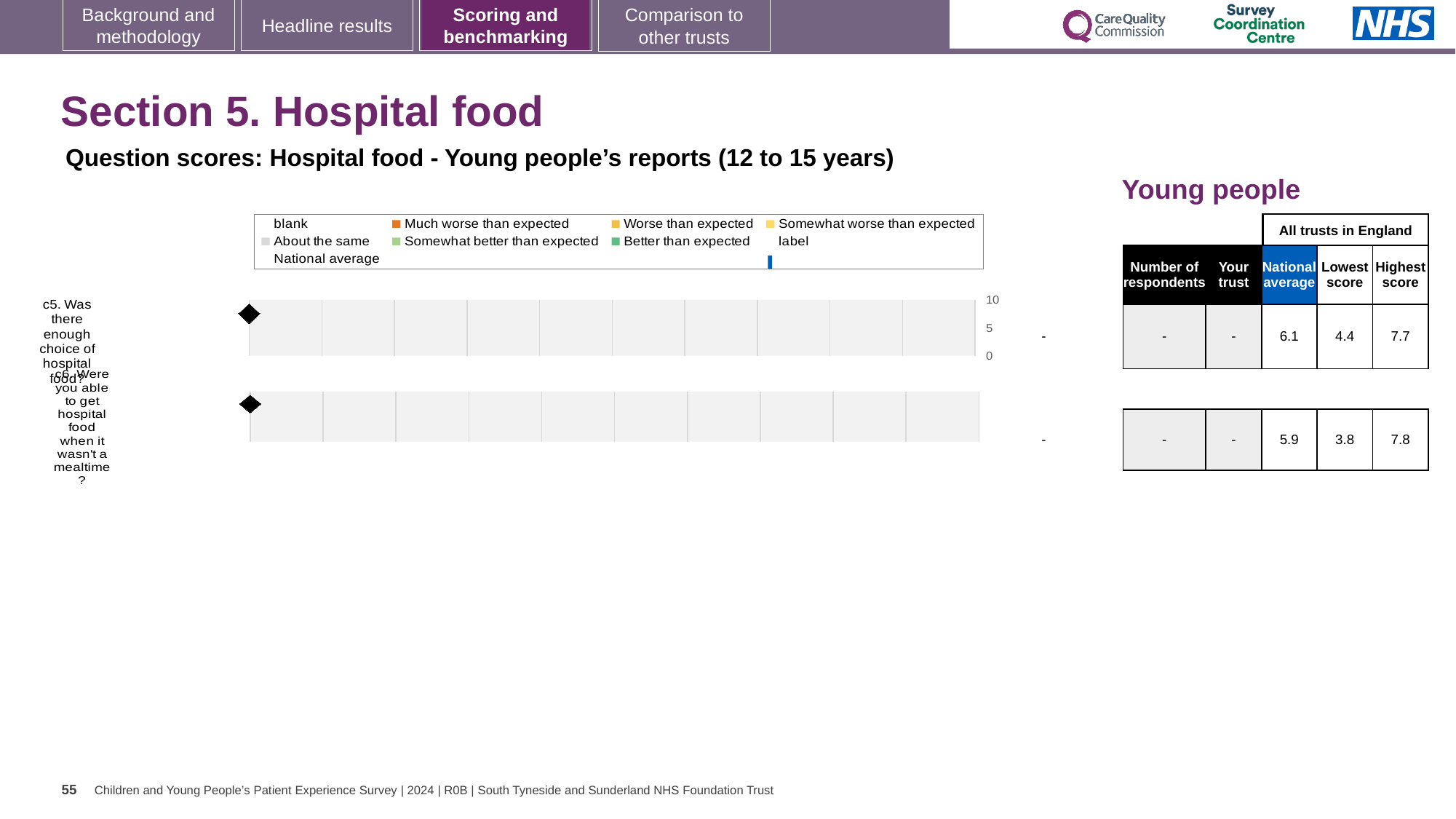
How many survey questions (categories) are listed on the chart's vertical axis? 2 What is the difference between the highest score and the lowest score for c5 in the table? 3.3 What kind of chart is shown on the slide? bar chart In the table beside the chart, what is the highest score for c6 (Were you able to get hospital food when it wasn't a mealtime?)? 7.8 In the table beside the chart, what is the national average score for c5 (Was there enough choice of hospital food?)? 6.1 In the table beside the chart, what is the lowest score for c5? 4.4 What value is shown in the 'Your trust' column for c5 in the table? - What is the maximum value shown on the chart's score axis? 10 What is the difference between the highest score and the lowest score for c6 in the table? 4.0 Which question has the higher national average in the table, c5 or c6? c5 Which question has the lower lowest score in the table, c5 or c6? c6